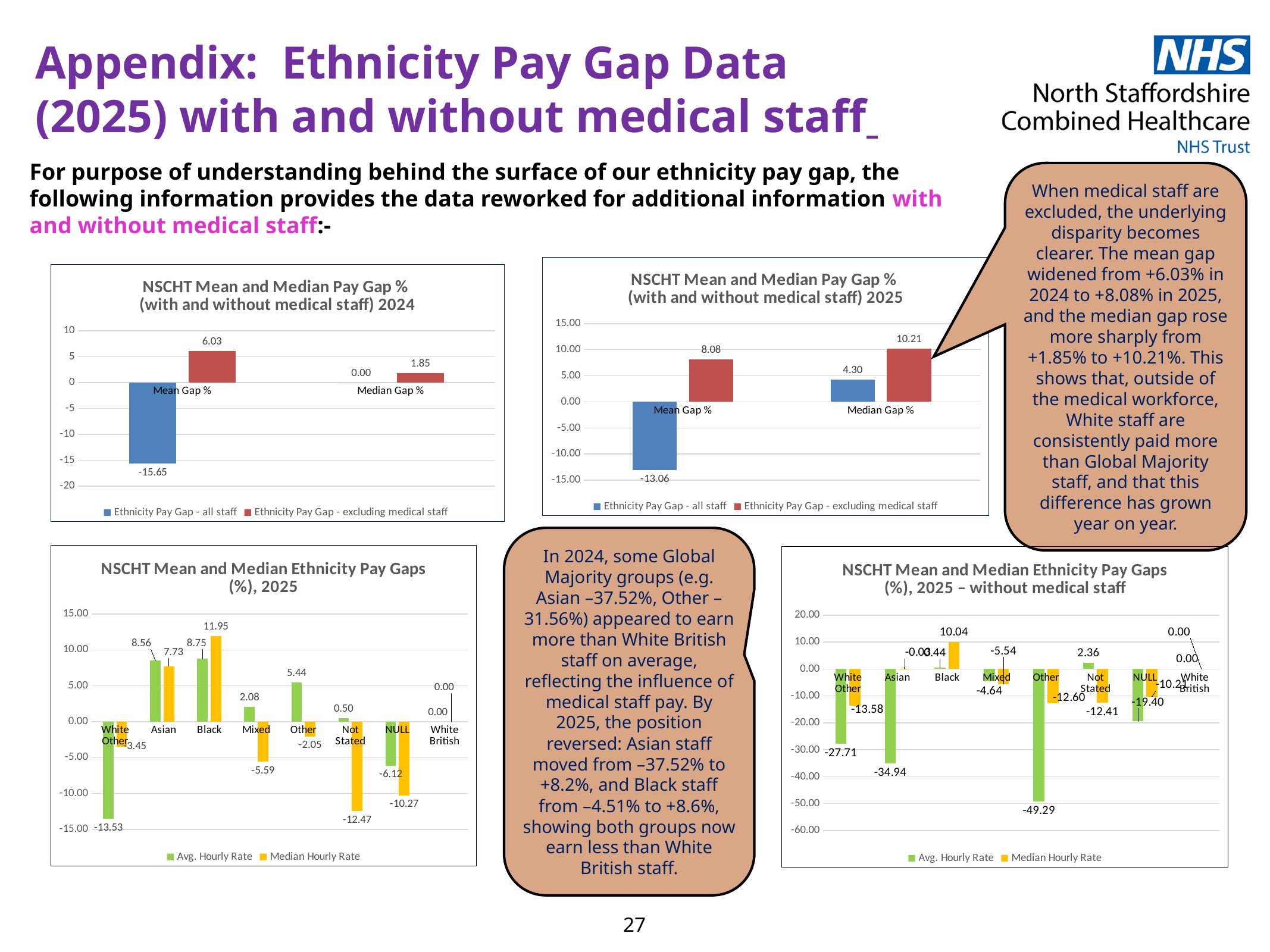
How many categories are shown on the x axis of the chart 'NSCHT Mean and Median Ethnicity Pay Gaps (%), 2025'? 8 In the 2024 chart 'NSCHT Mean and Median Pay Gap % (with and without medical staff) 2024', what is the Median Gap % excluding medical staff? 1.85 In the chart 'NSCHT Mean and Median Ethnicity Pay Gaps (%), 2025', which category has the highest Median Hourly Rate value? Black In the 2025 chart 'NSCHT Mean and Median Pay Gap % (with and without medical staff) 2025', what is the difference between the Median Gap % excluding medical staff and the Median Gap % for all staff? 5.91 In the 2024 chart 'NSCHT Mean and Median Pay Gap % (with and without medical staff) 2024', what is the Mean Gap % for all staff? -15.65 In the chart 'NSCHT Mean and Median Ethnicity Pay Gaps (%), 2025', what is the Avg. Hourly Rate value for White Other? -13.53 In the chart 'NSCHT Mean and Median Ethnicity Pay Gaps (%), 2025 – without medical staff', what is the Avg. Hourly Rate value for Asian? -34.94 What kind of chart is 'NSCHT Mean and Median Ethnicity Pay Gaps (%), 2025 – without medical staff'? Bar chart In the chart 'NSCHT Mean and Median Ethnicity Pay Gaps (%), 2025', what is the Median Hourly Rate value for Not Stated? -12.47 In the chart 'NSCHT Mean and Median Ethnicity Pay Gaps (%), 2025 – without medical staff', which category has the lowest Avg. Hourly Rate value? Other How many series does the legend list in the chart 'NSCHT Mean and Median Pay Gap % (with and without medical staff) 2025'? 2 In the 2025 chart 'NSCHT Mean and Median Pay Gap % (with and without medical staff) 2025', what is the Mean Gap % excluding medical staff? 8.08